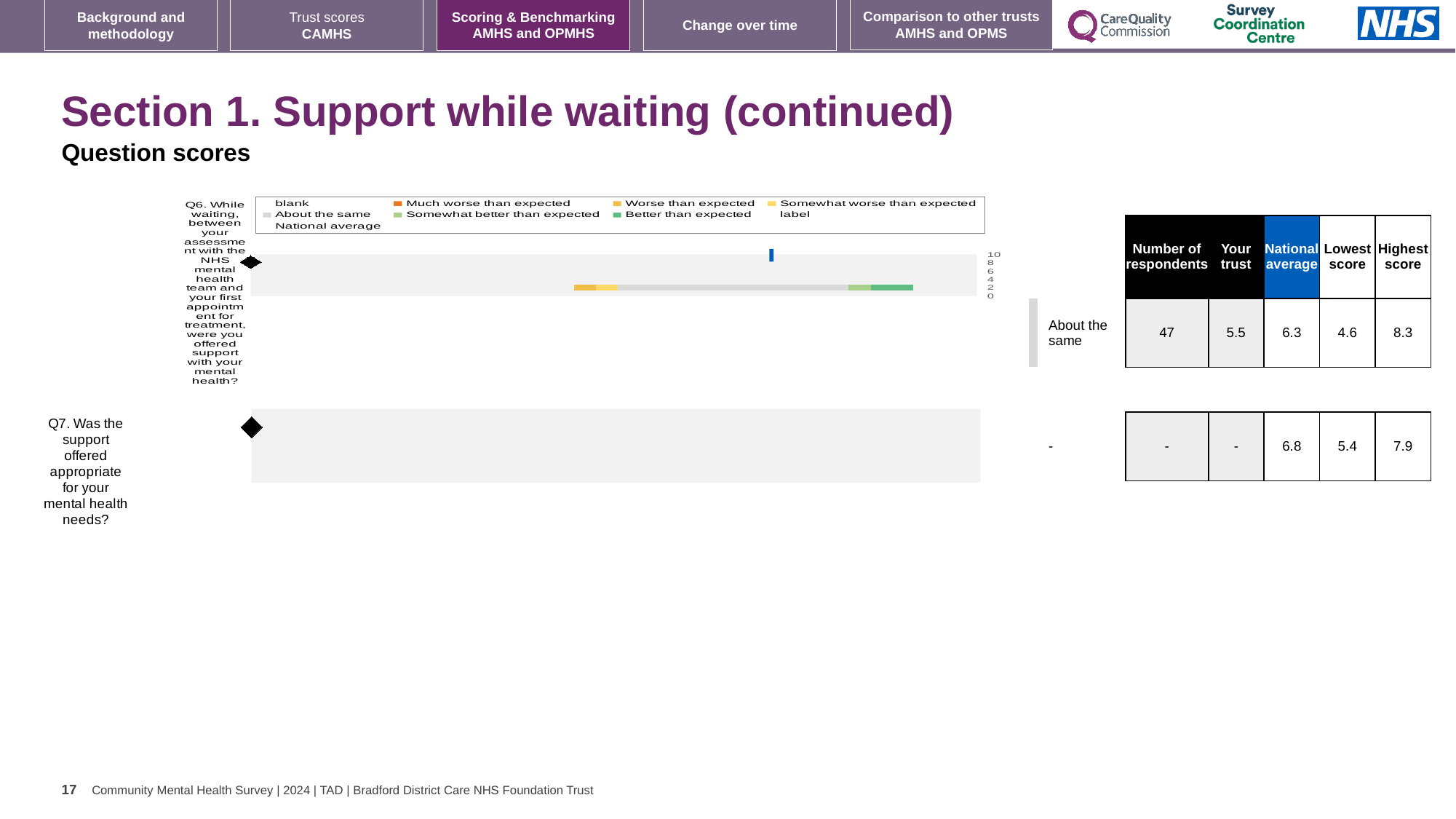
Is the national average marker for Q6 on the chart greater or less than 4? greater How many entries does the chart legend list? 9 In the table beside the chart, what is the difference between the highest and lowest score for Q6? 3.7 In the table beside the chart, how many respondents answered Q6? 47 What colour is the 'Much worse than expected' band in the chart legend? orange In the table beside the chart, what is the highest score for Q7? 7.9 In the table beside the chart, what is the national average for Q6? 6.3 Is the national average marker for Q6 on the chart greater or less than 8? less In the table beside the chart, which is larger for Q6: the national average or the 'Your trust' score? National average What kind of chart is used to show the Q6 benchmark bands? bar chart In the table beside the chart, what is the 'Your trust' score for Q6? 5.5 What colour is the 'Better than expected' band in the chart legend? green